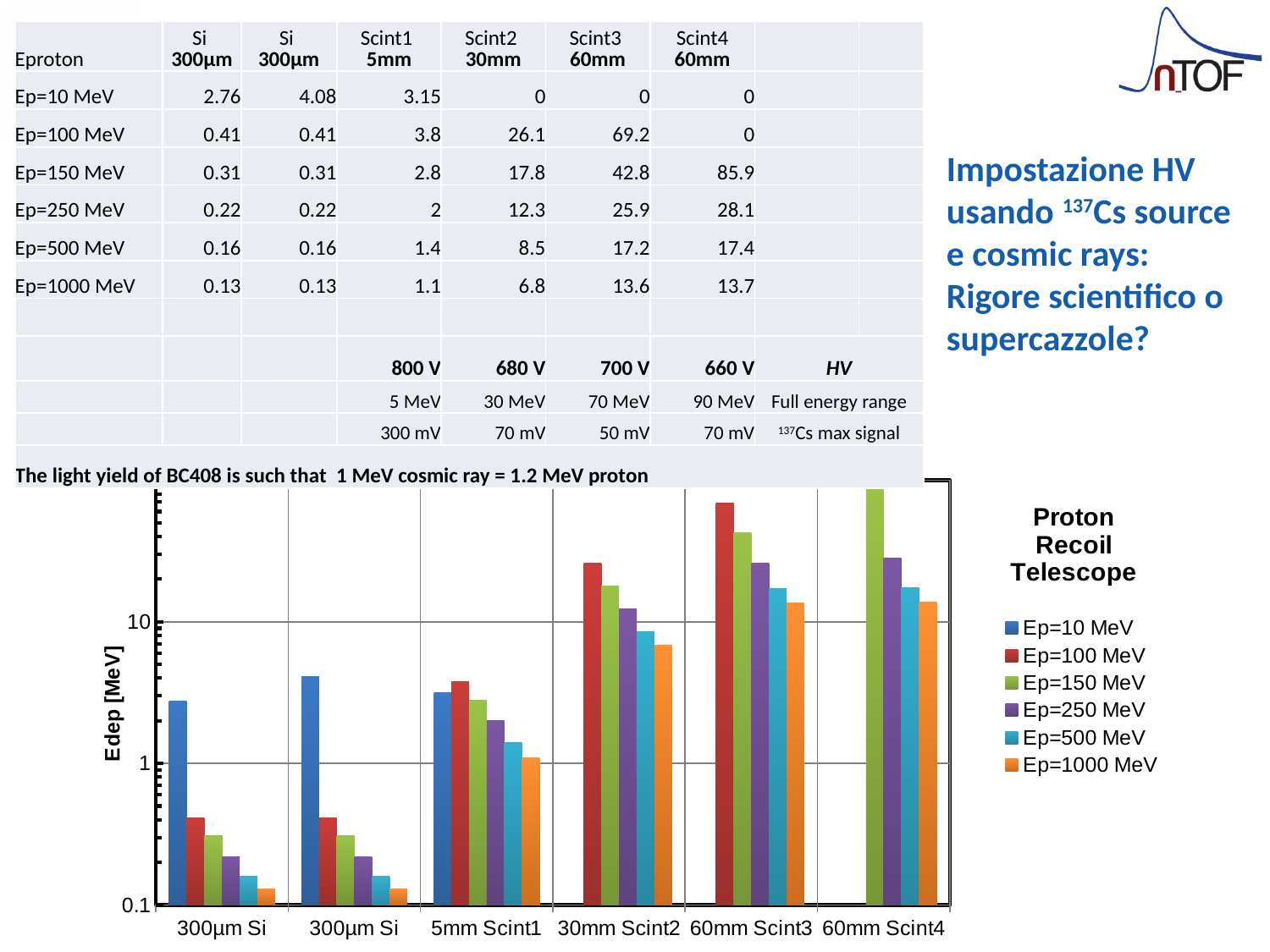
How many categories are shown along the x axis of the bar chart? 6 In the bar chart, which series has the highest bar for 60mm Scint3? Ep=100 MeV What is the label of the y axis of the bar chart? Edep [MeV] In the bar chart, is the Ep=1000 MeV value for 300µm Si greater or less than 1? less In the bar chart, is the Ep=10 MeV value for 5mm Scint1 greater or less than 1? greater According to the table, what is the Ep=150 MeV energy deposit for Scint4 60mm? 85.9 In the bar chart, which series has the highest bar for 60mm Scint4? Ep=150 MeV In the bar chart, for 30mm Scint2, which is larger: the Ep=100 MeV bar or the Ep=1000 MeV bar? Ep=100 MeV How many series does the legend of the bar chart list? 6 What kind of chart is shown at the bottom of the slide? bar chart In the bar chart, is the Ep=500 MeV value for 60mm Scint3 greater or less than 10? greater In the bar chart, do the Ep=1000 MeV bars rise or fall from 300µm Si to 60mm Scint4 along the x axis? rise